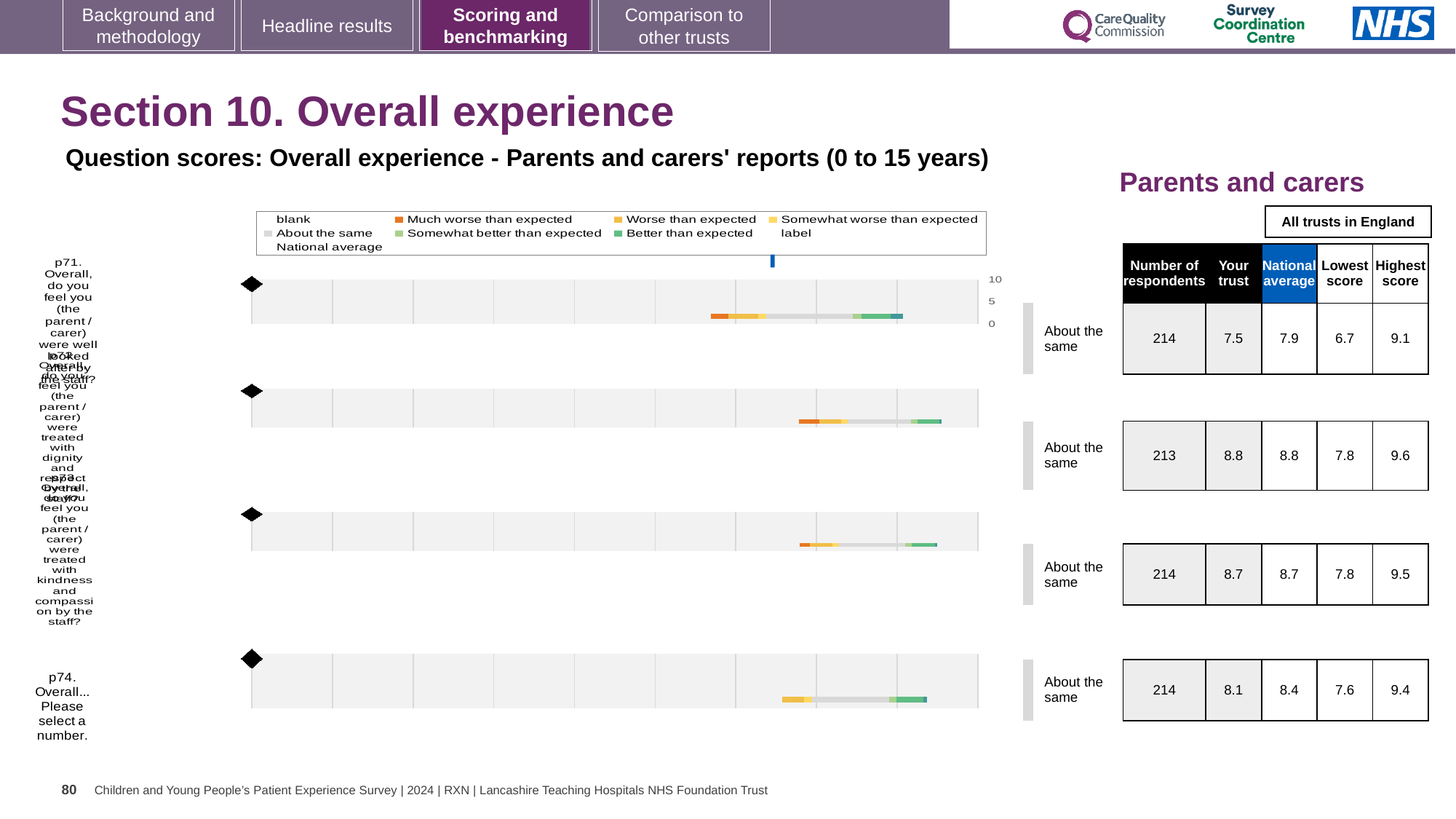
What is the difference between the national average and the trust score for p71? 0.4 What kind of chart is shown on the slide? bar chart What is the 'Your trust' score for p71 (Overall, do you feel you were well looked after by the staff?)? 7.5 Is the trust score for p71 greater or less than 5? greater Which question has the highest 'Your trust' score? p72 What is the highest score across all trusts in England for p72? 9.6 How many respondents answered p72? 213 How many questions (rows) are plotted in the chart? 4 What benchmark category is shown for p73? About the same Which question has the lowest 'Your trust' score? p71 How many entries does the chart legend list? 9 What is the national average score for p74 (Overall... Please select a number)? 8.4